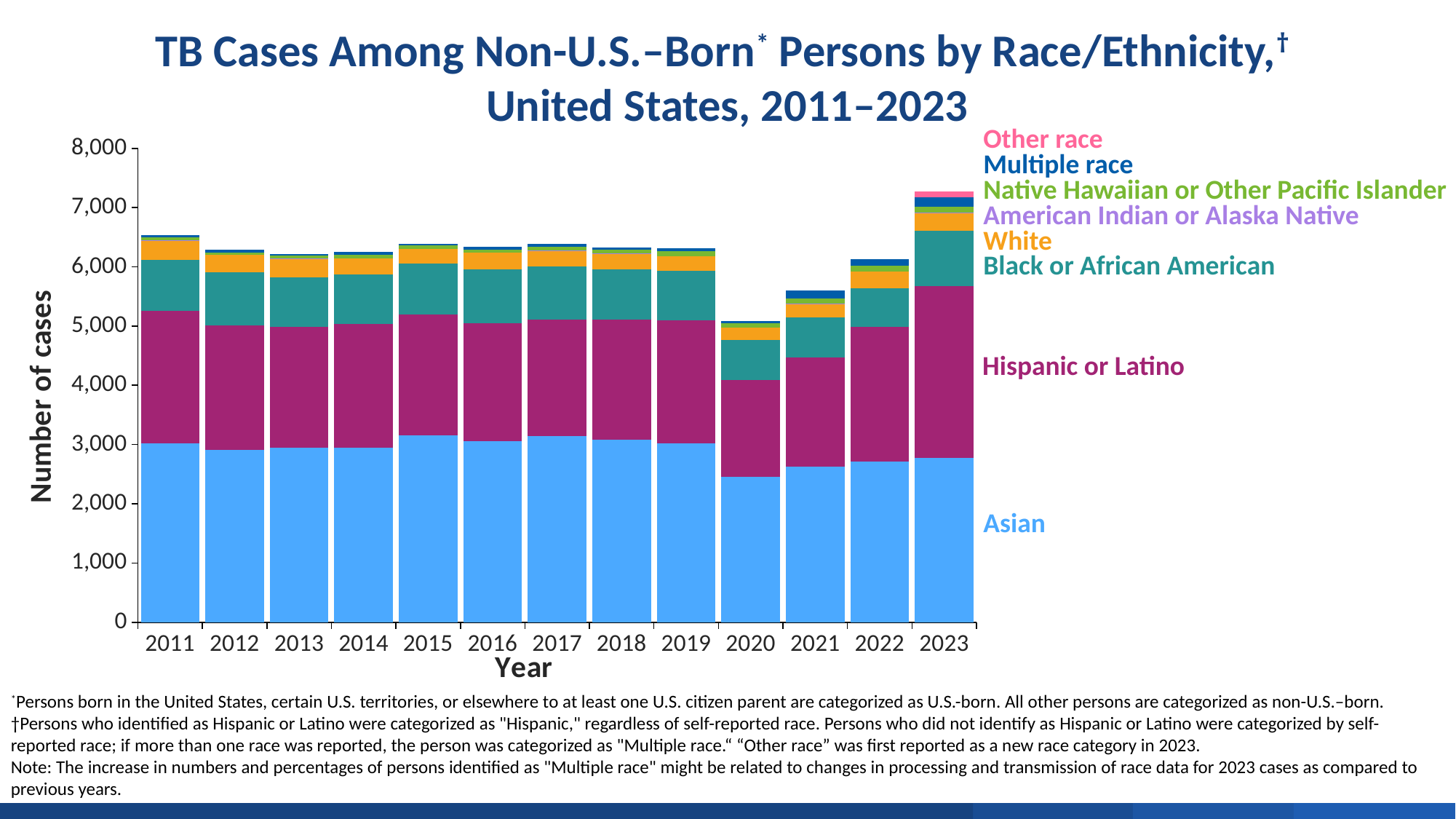
Did the total number of cases rise or fall from 2019 to 2020? Fall How many years are shown along the x axis of the chart? 13 Which year has the lowest total number of TB cases among non-U.S.-born persons? 2020 How many race/ethnicity series does the legend list? 8 Is the total number of cases in 2020 greater or less than 6,000? less What is the title of the chart? TB Cases Among Non-U.S.–Born Persons by Race/Ethnicity, United States, 2011–2023 What kind of chart is shown on the slide? Stacked bar chart Which race/ethnicity group forms the bottom segment of each stacked bar? Asian Which year has the highest total number of TB cases among non-U.S.-born persons? 2023 Is the total number of cases in 2023 greater or less than 7,000? greater Which year has a larger total number of cases, 2021 or 2022? 2022 Is the number of Asian cases in 2020 greater or less than 3,000? less